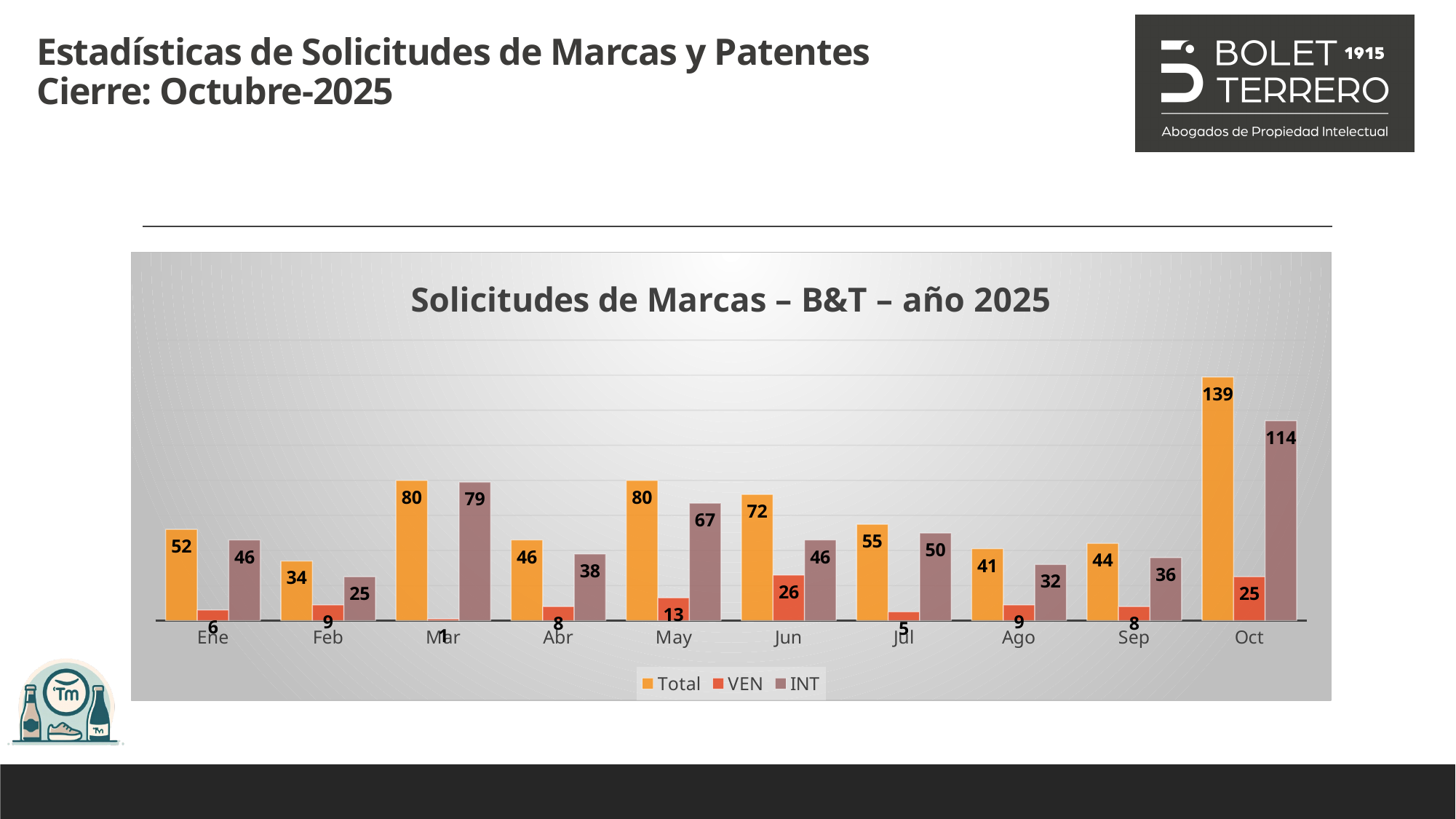
What is the Total value for Oct? 139 Which is larger, the INT value for May or the INT value for Jun? May What kind of chart is shown on the slide? Bar chart How many series does the legend list? 3 Which month has the lowest Total value? Feb Which series is shown in orange in the legend? Total Which month has the highest Total value? Oct How many months are shown on the x axis? 10 What is the VEN value for Jun? 26 What is the title of the chart? Solicitudes de Marcas – B&T – año 2025 What is the INT value for Mar? 79 What is the difference between the Total values for Oct and Sep? 95